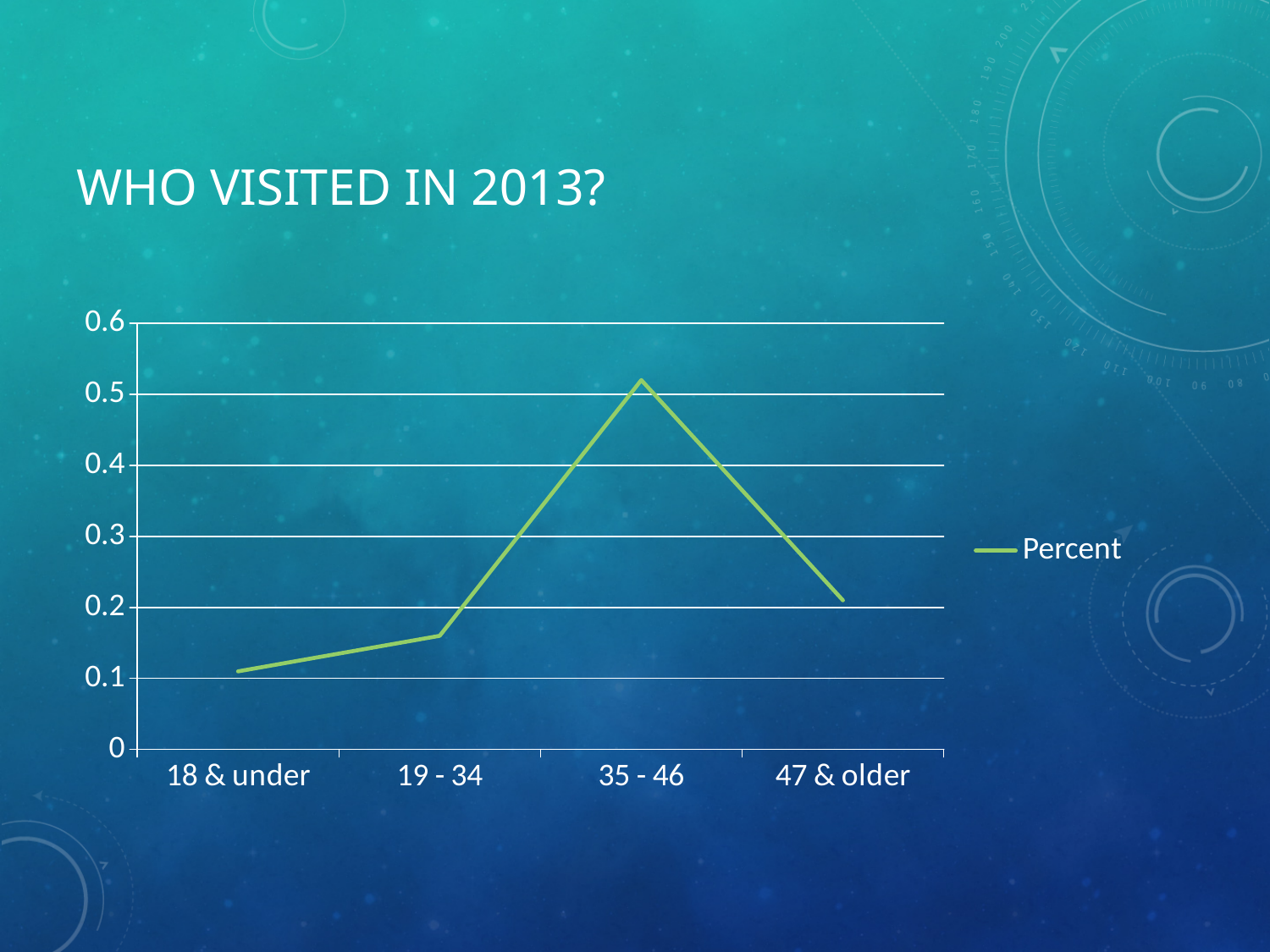
Which has the larger value, 35 - 46 or 47 & older? 35 - 46 Is the value for 35 - 46 greater or less than 0.4? greater Is the value for 47 & older greater or less than 0.3? less Which age category has the lowest value? 18 & under Which age category has the highest value? 35 - 46 Does the value rise or fall from 35 - 46 to 47 & older? fall What is the name of the series shown in the legend? Percent How many series does the legend list? 1 What is the title of the chart on the slide? WHO VISITED IN 2013? Is the value for 18 & under greater or less than 0.2? less How many age categories are plotted on the x axis? 4 What kind of chart is shown on the slide? line chart